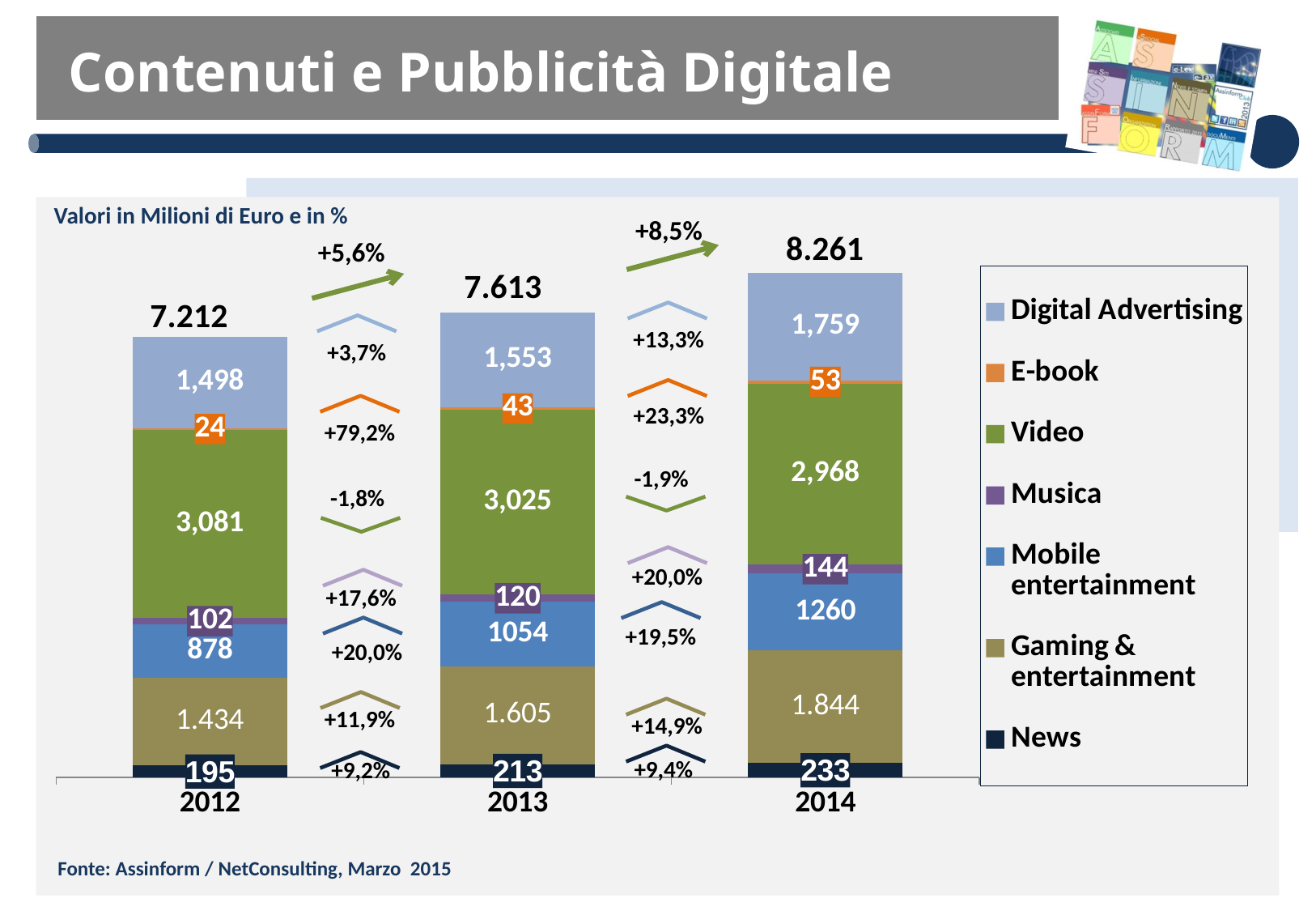
How many series does the legend list? 7 What is the difference between the Digital Advertising values for 2014 and 2013? 206 Which is larger, the Video value in 2012 or the Video value in 2014? 2012 Which segment is the largest in the 2014 bar? Video What is the total of the stacked bar for 2014? 8.261 What is the value of the E-book segment in 2014? 53 Do the bar totals rise or fall from 2012 to 2014? Rise What is the value of the Video segment for 2013? 3,025 What kind of chart is shown on the slide? Stacked bar chart Which segment is the smallest in the 2012 bar? E-book What is the value of Mobile entertainment in 2012? 878 How many years are shown on the x axis? 3